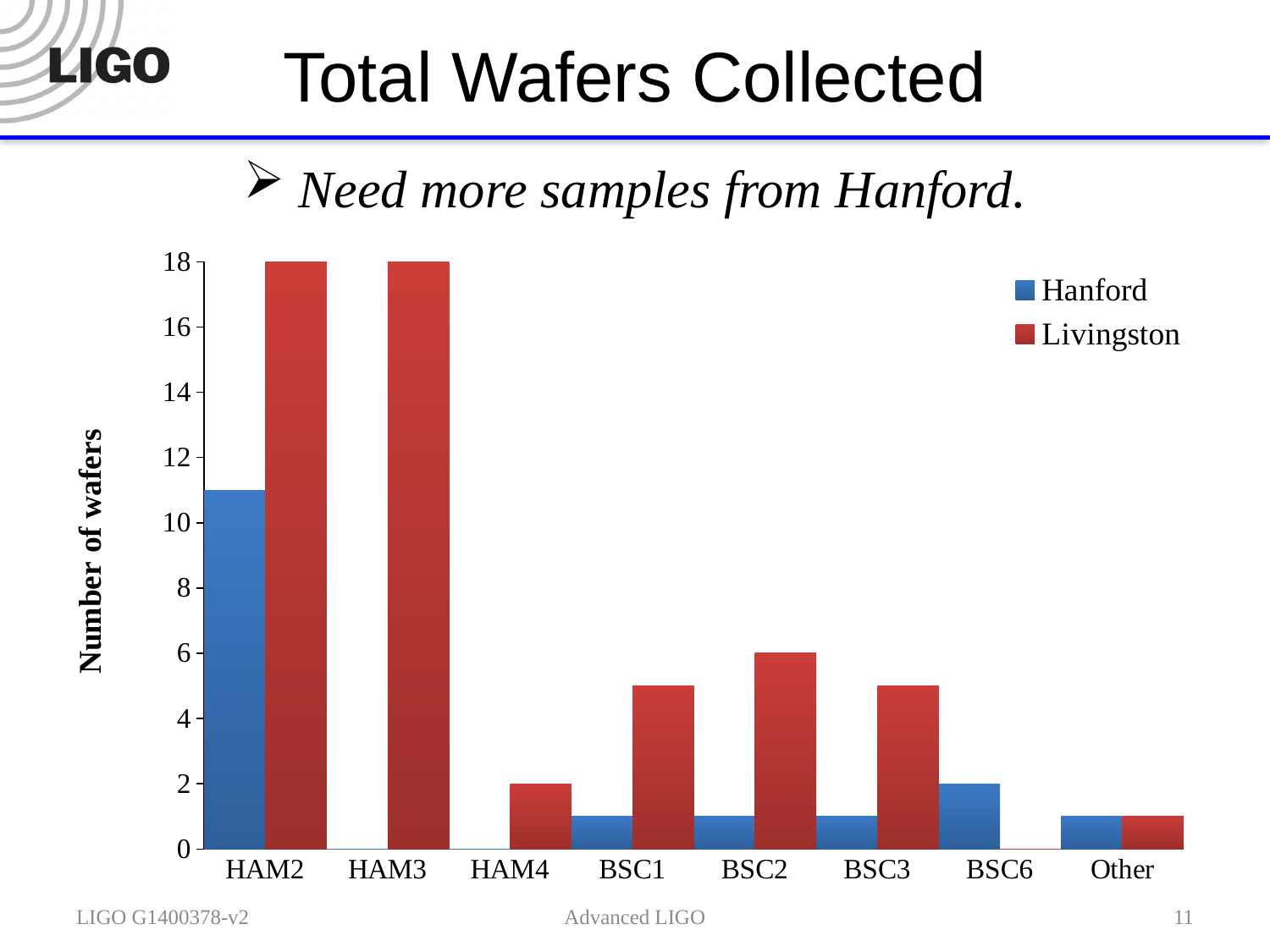
Is the Hanford value for HAM2 greater or less than 10? greater What is the number of wafers for Livingston at HAM3? 18 What kind of chart is shown on the slide? bar chart What is the number of wafers for Livingston at HAM2? 18 What is the label of the y axis? Number of wafers Which category has the highest Hanford value? HAM2 What is the difference between the Livingston values at HAM2 and HAM4? 16 At HAM2, which series has the larger value, Hanford or Livingston? Livingston What is the number of wafers for Hanford at BSC6? 2 How many series does the legend list? 2 What is the number of wafers for Livingston at BSC2? 6 How many categories are shown on the x axis? 8